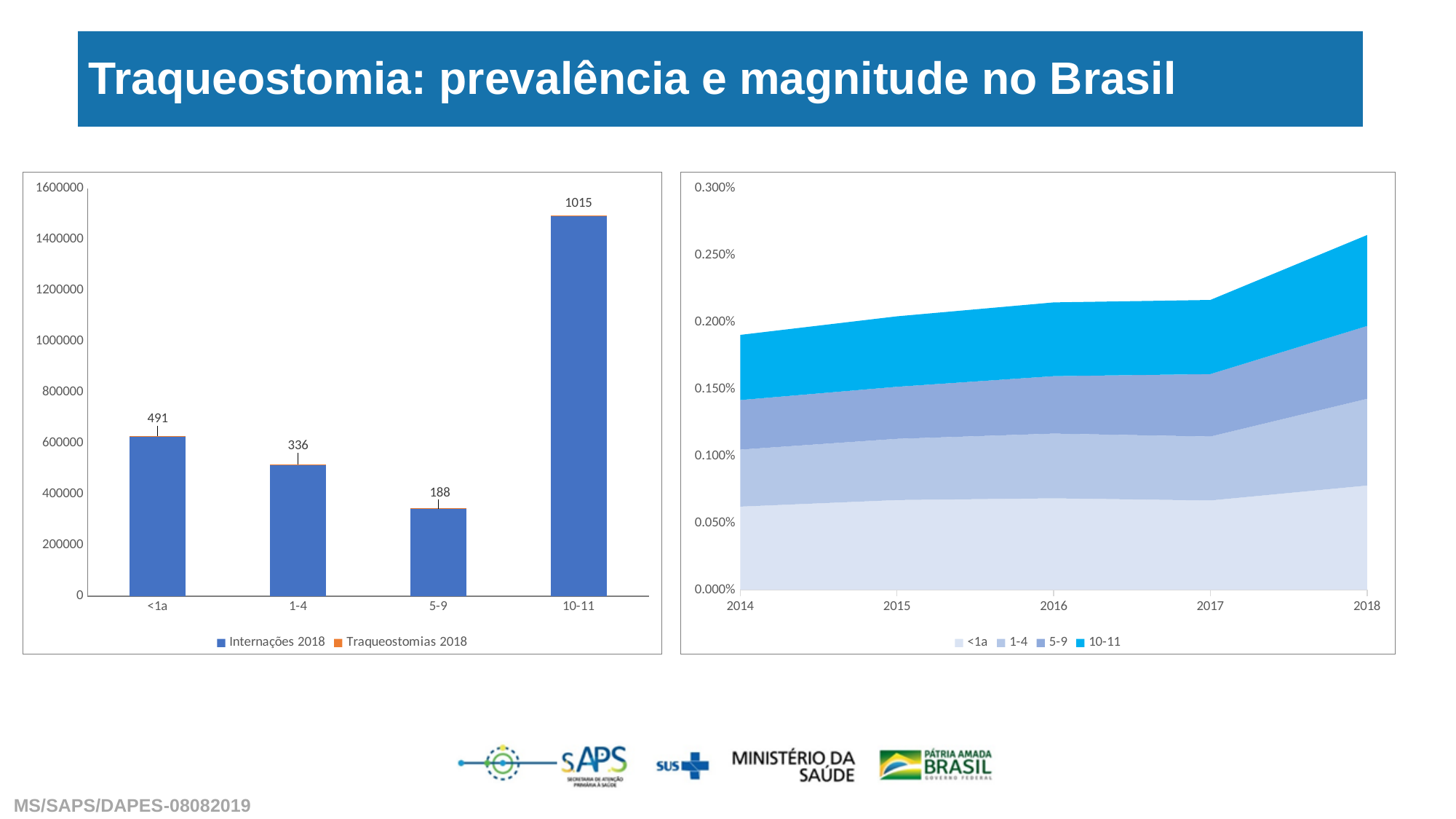
On the left chart, which age group has the highest Traqueostomias 2018 value? 10-11 On the left chart, is the Internações 2018 value for 5-9 greater or less than 400000? less How many series does the legend of the left chart list? 2 On the left chart, is the Internações 2018 value for 10-11 greater or less than 1400000? greater On the left chart, which has a larger Traqueostomias 2018 value, 1-4 or 5-9? 1-4 On the right chart, does the total stacked value rise or fall from 2014 to 2018? Rises On the left chart, what is the value of Traqueostomias 2018 for the <1a age group? 491 On the left chart, which age group has the lowest Traqueostomias 2018 value? 5-9 On the left chart, what is the value of Traqueostomias 2018 for the 10-11 age group? 1015 On the left chart, what is the difference between the Traqueostomias 2018 values for <1a and 1-4? 155 What kind of chart is the chart on the right of the slide? Stacked area chart How many years are shown on the x axis of the right chart? 5